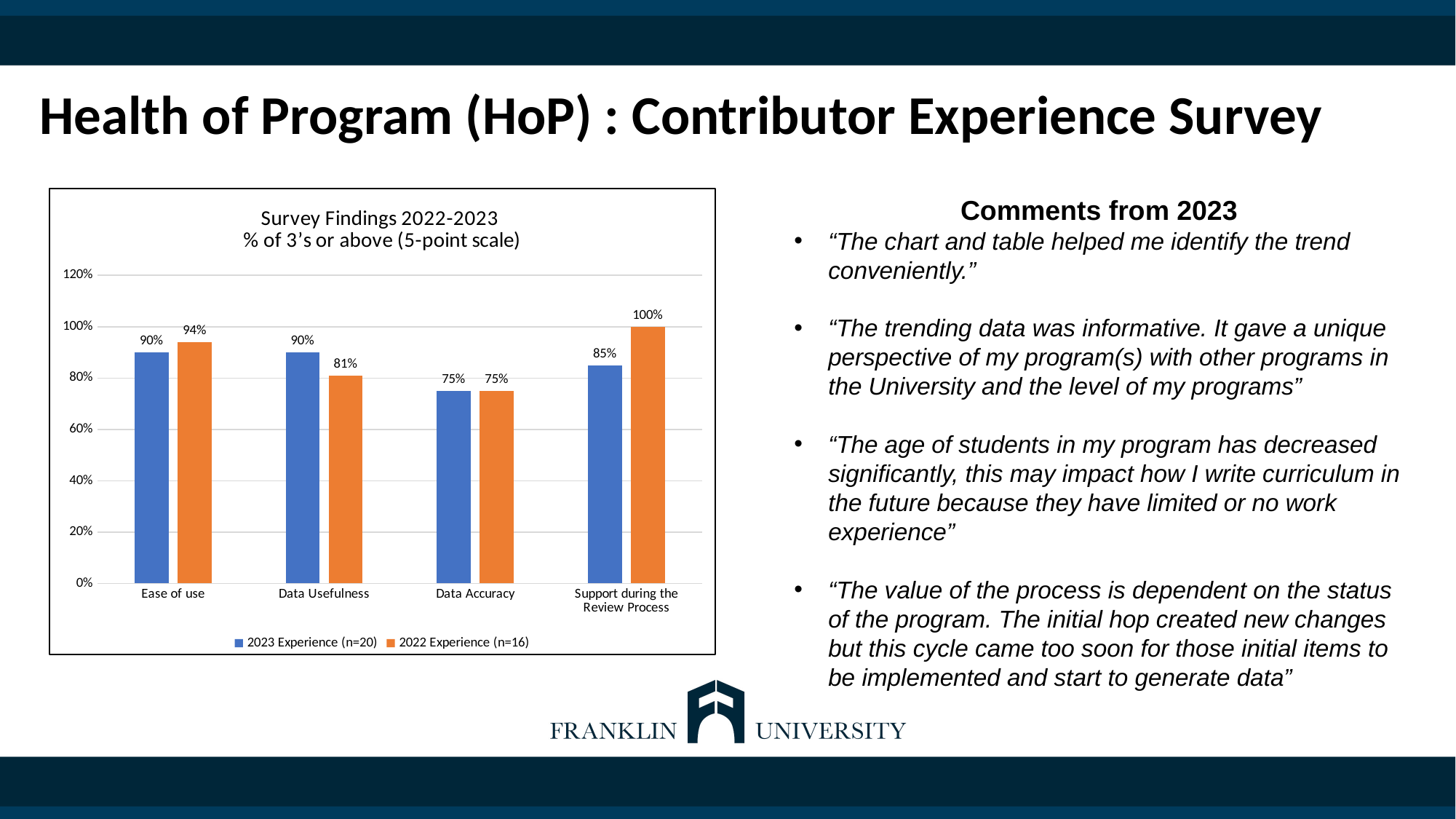
What kind of chart is shown on the slide? Bar chart What is the 2022 Experience value for Support during the Review Process? 100% How many categories are shown on the x axis? 4 What is the 2023 Experience value for Ease of use? 90% What is the title of the chart? Survey Findings 2022-2023 % of 3's or above (5-point scale) Which category has the lowest 2023 Experience value? Data Accuracy What colour are the 2022 Experience (n=16) bars? Orange How many series does the legend list? 2 Which category has the highest 2022 Experience value? Support during the Review Process Which is larger for Data Usefulness, the 2023 Experience value or the 2022 Experience value? 2023 Experience What is the difference between the 2022 and 2023 Experience values for Support during the Review Process? 15% What is the 2022 Experience value for Data Usefulness? 81%